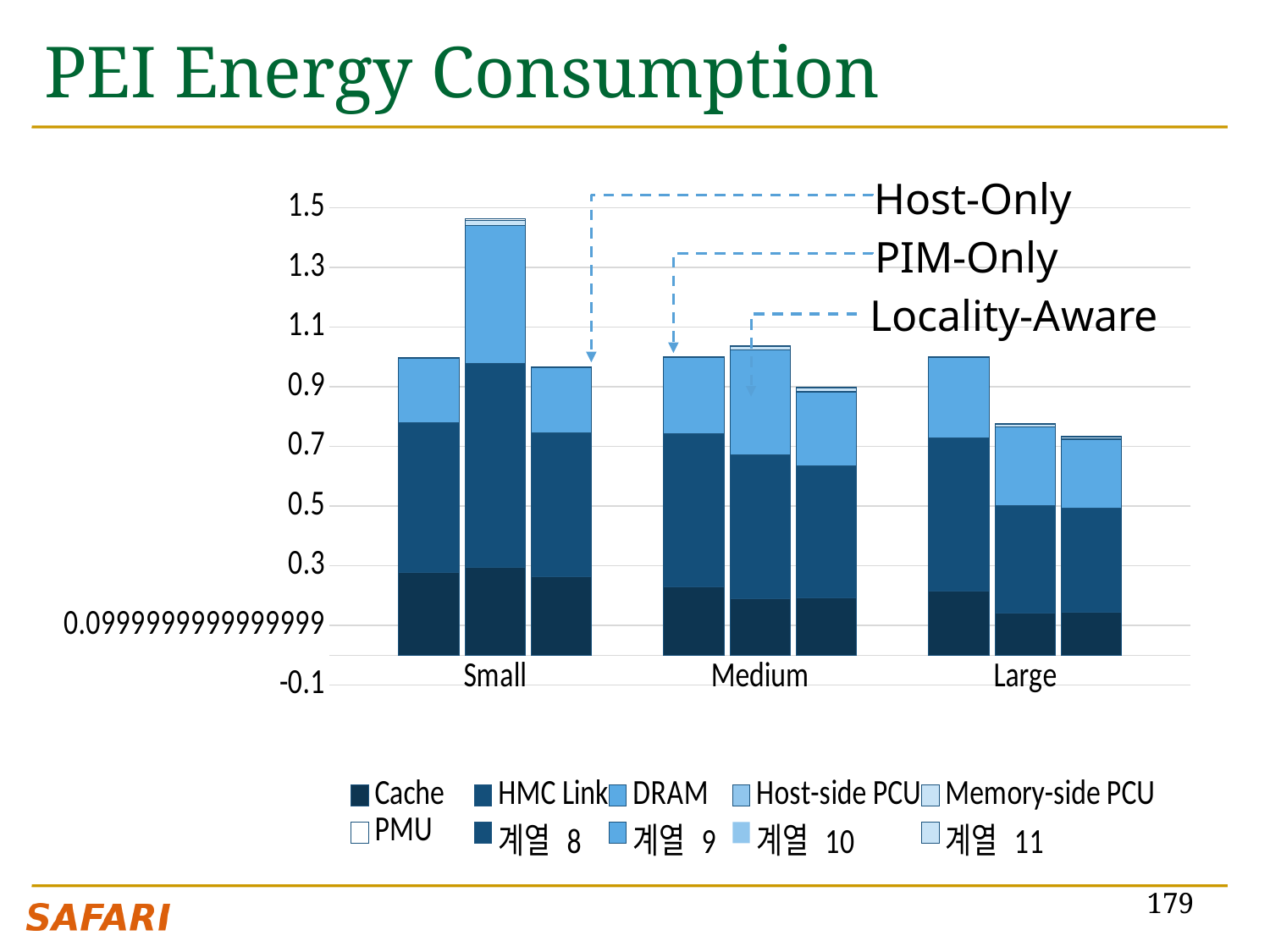
Is the total value of the PIM-Only bar for Small greater or less than 1.3? greater Is the total value of the Locality-Aware bar for Large greater or less than 0.9? less For Small, which bar is taller: PIM-Only or Locality-Aware? PIM-Only What is the title of the chart? PEI Energy Consumption How many series does the chart's legend list? 10 Which three configurations are labelled by the dashed arrows on the chart? Host-Only, PIM-Only, Locality-Aware For Large, which bar is taller: Host-Only or Locality-Aware? Host-Only What kind of chart is shown on the slide? stacked bar chart How many categories are shown along the x axis of the chart? 3 Do the Locality-Aware bars rise or fall from Small to Large? fall Is the total value of the PIM-Only bar for Large greater or less than 0.9? less Which bar is the tallest in the chart? PIM-Only for Small